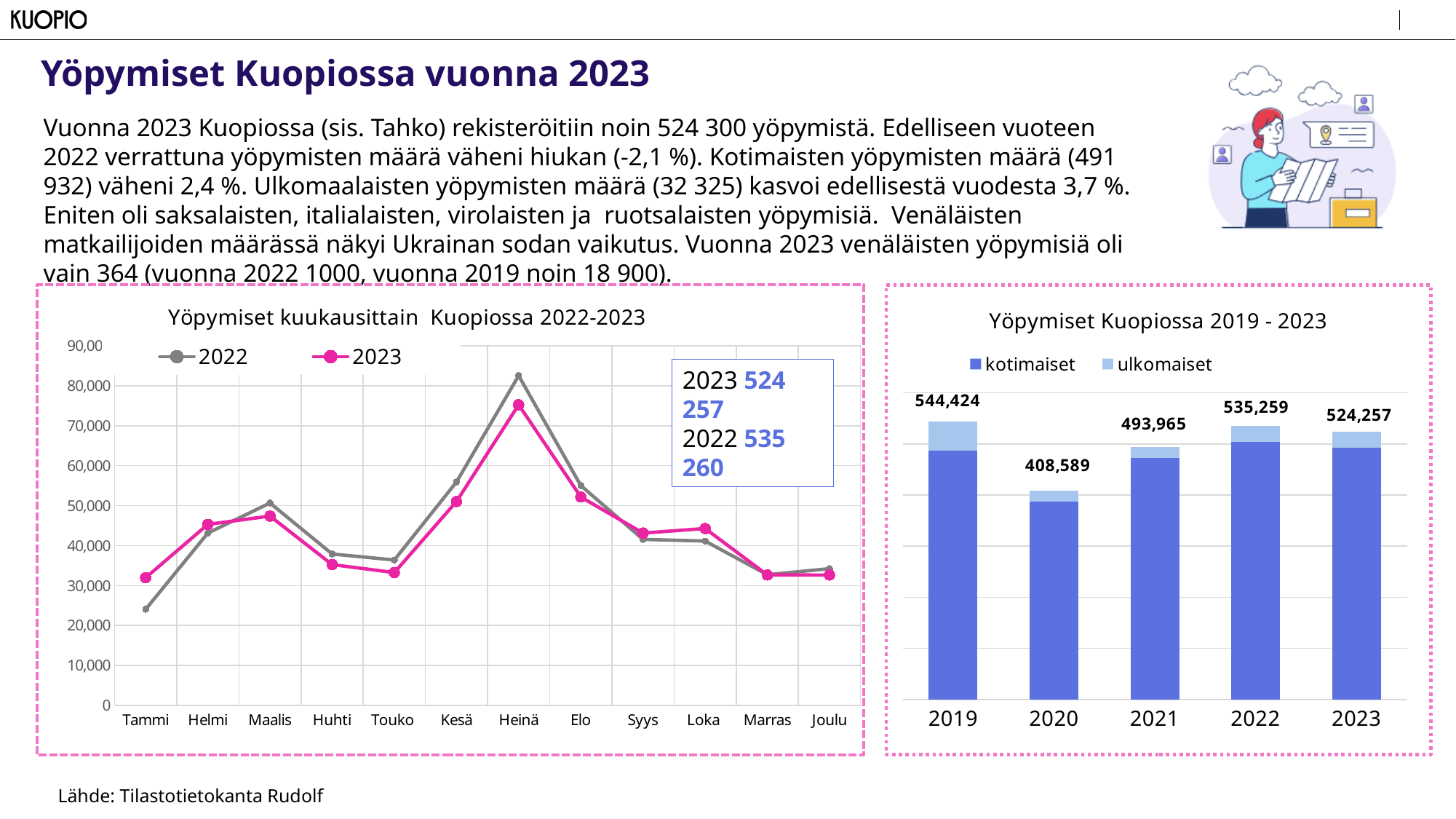
In the chart 'Yöpymiset kuukausittain Kuopiossa 2022-2023', is the 2022 value for Heinä greater or less than 80,000? greater In the chart 'Yöpymiset Kuopiossa 2019 - 2023', which year has the lowest total? 2020 In the chart 'Yöpymiset Kuopiossa 2019 - 2023', how many series does the legend list? 2 In the chart 'Yöpymiset kuukausittain Kuopiossa 2022-2023', how many months are shown on the x axis? 12 What kind of chart is 'Yöpymiset Kuopiossa 2019 - 2023'? Stacked bar chart In the chart 'Yöpymiset kuukausittain Kuopiossa 2022-2023', which series has the larger value in Tammi, 2022 or 2023? 2023 In the chart 'Yöpymiset Kuopiossa 2019 - 2023', which year has the highest total? 2019 What kind of chart is 'Yöpymiset kuukausittain Kuopiossa 2022-2023'? Line chart In the chart 'Yöpymiset kuukausittain Kuopiossa 2022-2023', in which month does the 2023 series reach its highest value? Heinä In the chart 'Yöpymiset Kuopiossa 2019 - 2023', how many years are shown on the x axis? 5 In the chart 'Yöpymiset Kuopiossa 2019 - 2023', what is the total value labelled for 2020? 408,589 In the chart 'Yöpymiset Kuopiossa 2019 - 2023', what is the difference between the totals for 2022 and 2023? 11,002